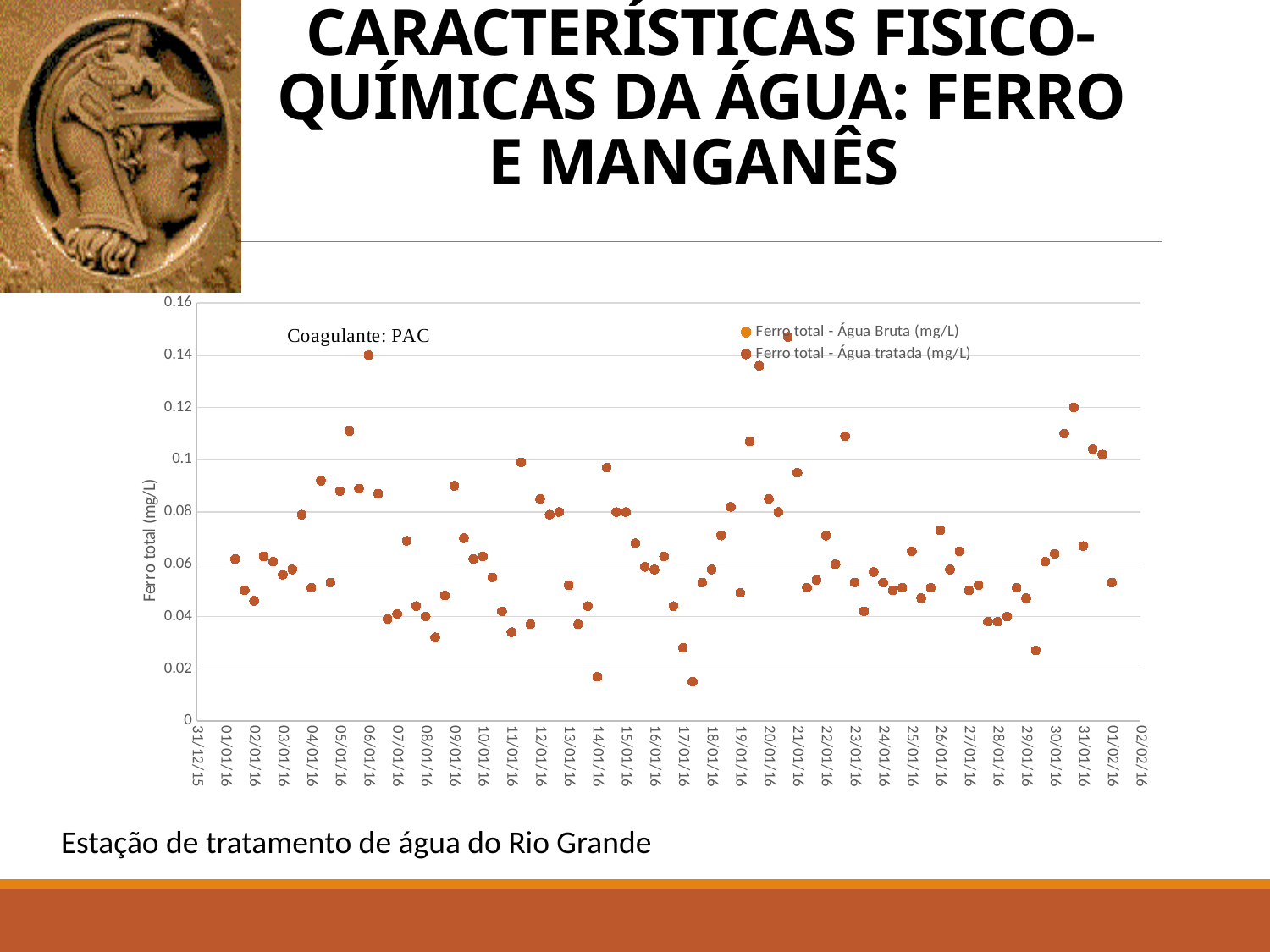
What coagulant is named in the annotation inside the chart? PAC What is the label of the chart's vertical axis? Ferro total (mg/L) How many series does the chart legend list? 2 Is the lowest point plotted near 14/01/16 greater or less than 0.02? less Is the highest point plotted near 06/01/16 greater or less than 0.12? greater What kind of chart is shown on the slide? Scatter chart What are the two series named in the chart legend? Ferro total - Água Bruta (mg/L) and Ferro total - Água tratada (mg/L) What is the first date label on the chart's horizontal axis? 31/12/15 What is the highest tick value shown on the chart's vertical axis? 0.16 Is the lowest point plotted near 17/01/16 greater or less than 0.02? less What is the last date label on the chart's horizontal axis? 02/02/16